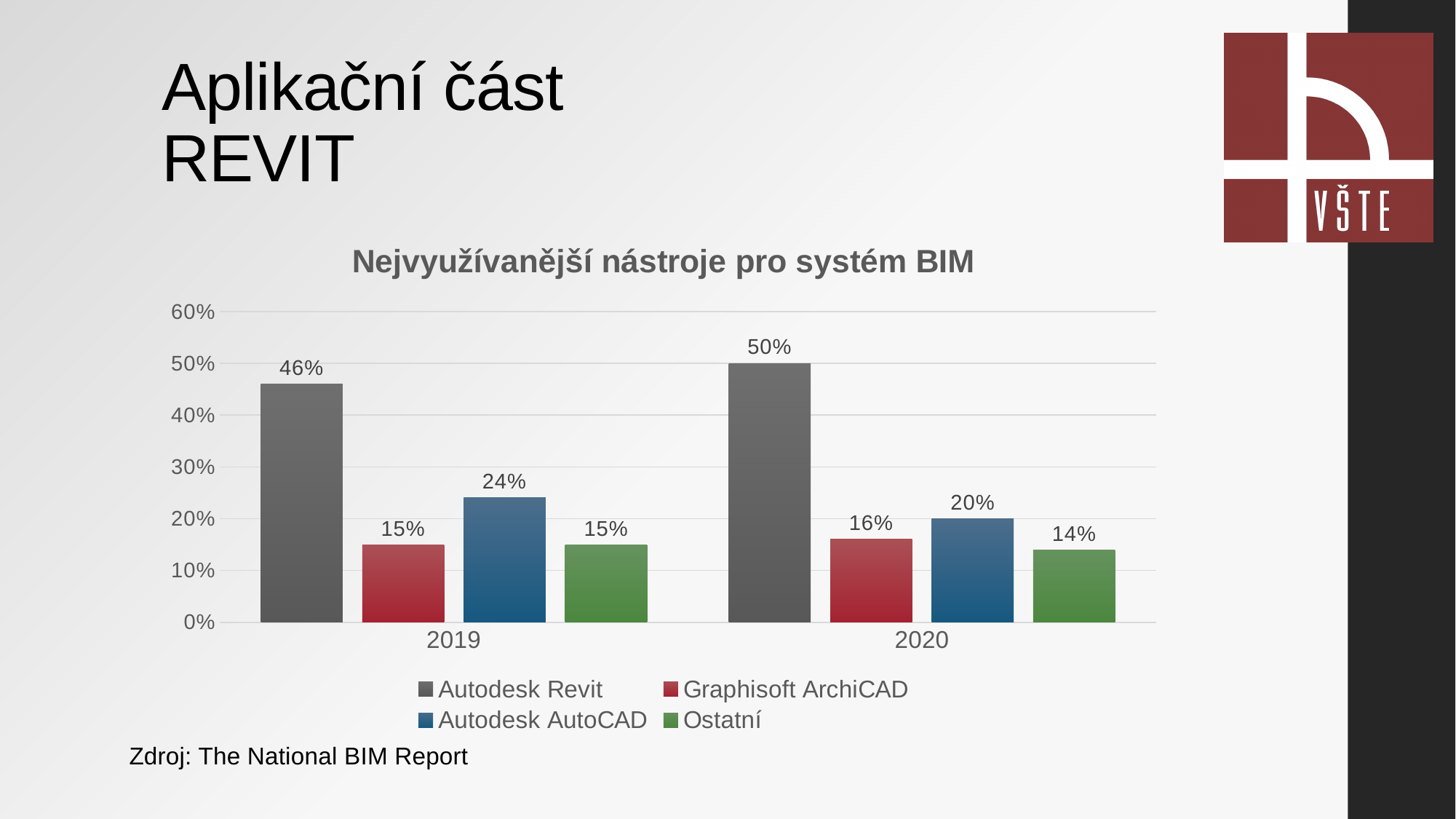
What is the difference between the Autodesk Revit values for 2020 and 2019? 4% How many year categories are shown on the x axis? 2 What is the value for Autodesk AutoCAD in 2020? 20% What kind of chart is shown on the slide? Bar chart Which is larger: Autodesk AutoCAD in 2019 or Autodesk AutoCAD in 2020? Autodesk AutoCAD in 2019 How many series does the legend list? 4 Which tool has the highest value in 2020? Autodesk Revit What is the title of the chart? Nejvyužívanější nástroje pro systém BIM What is the value for Ostatní in 2019? 15% What is the value for Autodesk Revit in 2019? 46% Which tool has the lowest value in 2020? Ostatní What is the value for Graphisoft ArchiCAD in 2020? 16%